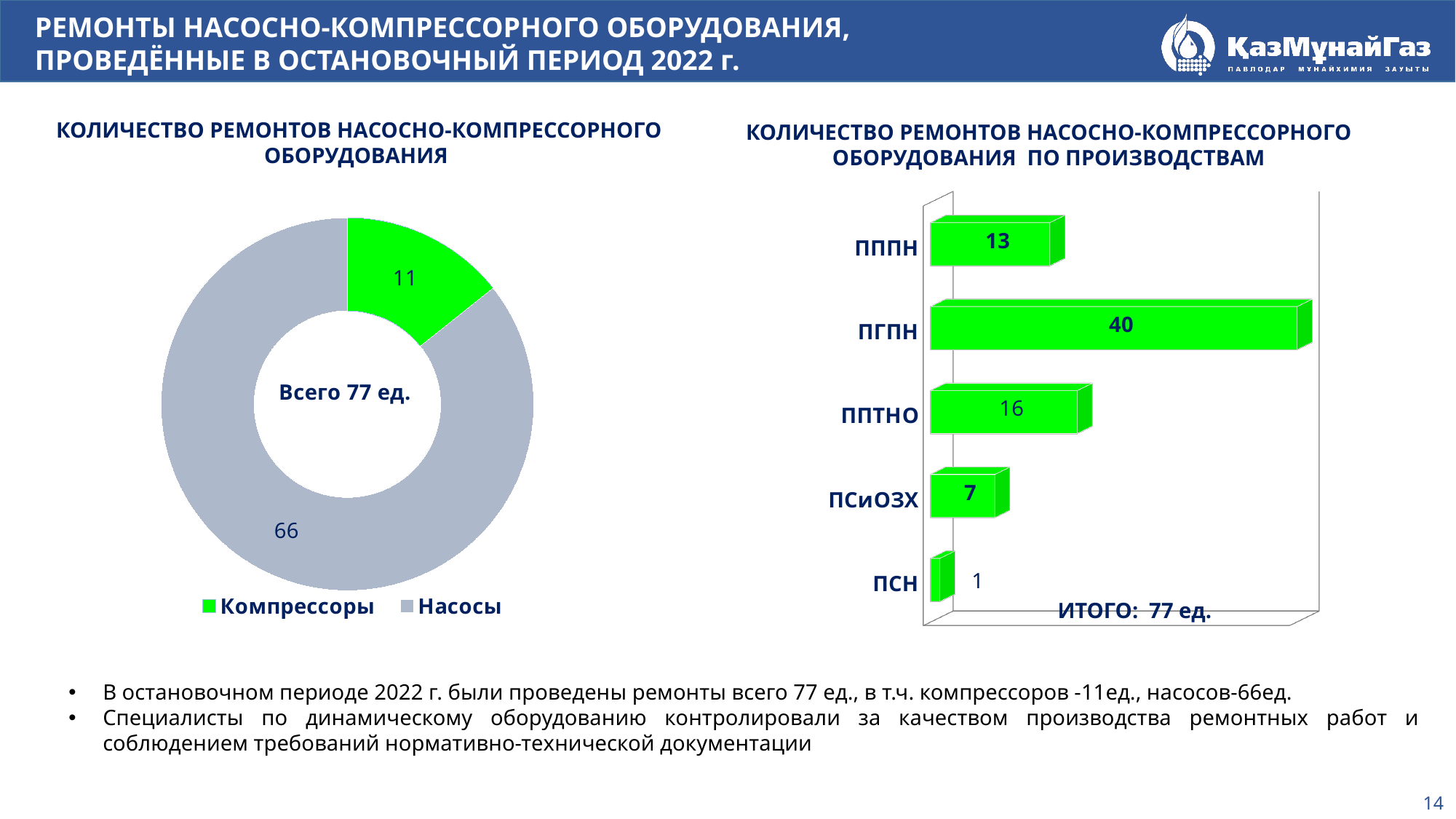
In the left chart (КОЛИЧЕСТВО РЕМОНТОВ НАСОСНО-КОМПРЕССОРНОГО ОБОРУДОВАНИЯ), what is the value for Насосы? 66 In the right chart (КОЛИЧЕСТВО РЕМОНТОВ ... ПО ПРОИЗВОДСТВАМ), which category has the highest value? ПГПН What kind of chart is the left chart (КОЛИЧЕСТВО РЕМОНТОВ НАСОСНО-КОМПРЕССОРНОГО ОБОРУДОВАНИЯ)? Doughnut (pie) chart In the right chart (КОЛИЧЕСТВО РЕМОНТОВ ... ПО ПРОИЗВОДСТВАМ), how many categories are shown? 5 In the right chart (КОЛИЧЕСТВО РЕМОНТОВ ... ПО ПРОИЗВОДСТВАМ), what is the value for ПГПН? 40 In the left chart, how many entries does the legend list? 2 In the right chart (КОЛИЧЕСТВО РЕМОНТОВ ... ПО ПРОИЗВОДСТВАМ), what is the value for ППТНО? 16 In the left chart (КОЛИЧЕСТВО РЕМОНТОВ НАСОСНО-КОМПРЕССОРНОГО ОБОРУДОВАНИЯ), what is the value for Компрессоры? 11 In the left chart, what is the difference between Насосы and Компрессоры? 55 In the right chart (КОЛИЧЕСТВО РЕМОНТОВ ... ПО ПРОИЗВОДСТВАМ), which is larger: ПППН or ПСиОЗХ? ПППН In the right chart (КОЛИЧЕСТВО РЕМОНТОВ ... ПО ПРОИЗВОДСТВАМ), which category has the lowest value? ПСН In the left chart, what total is shown in the centre of the doughnut? Всего 77 ед.